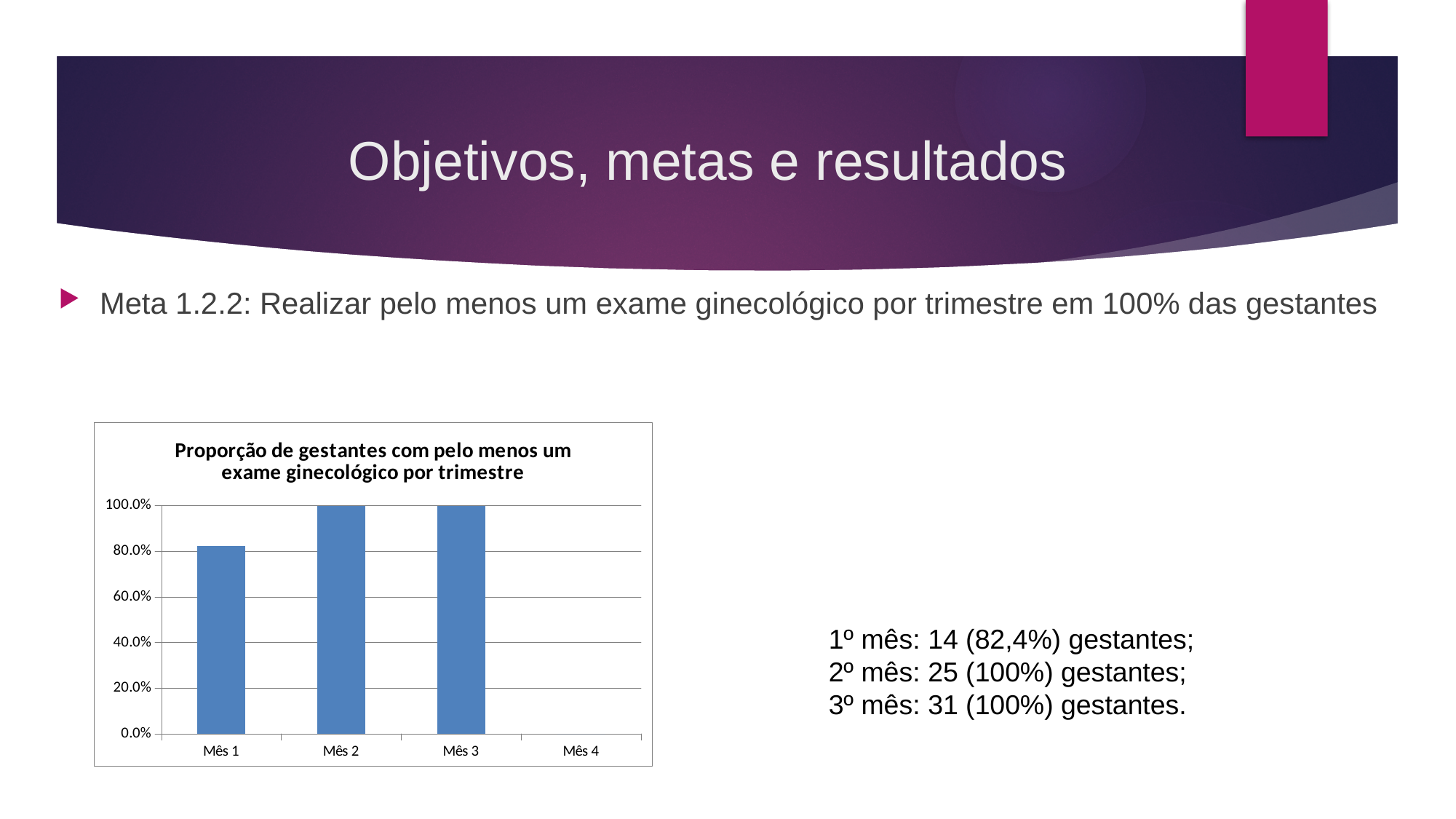
Is the value for Mês 1 greater or less than 100.0%? less How many bars are plotted in the chart? 3 Which is larger, the value for Mês 1 or the value for Mês 2? Mês 2 What is the title of the chart? Proporção de gestantes com pelo menos um exame ginecológico por trimestre Is the value for Mês 1 greater or less than 60.0%? greater Do the values rise or fall from Mês 1 to Mês 2? rise How many categories are labelled on the x axis of the chart? 4 What is the value for Mês 2 in the chart? 100.0% According to the slide, what proportion of gestantes had the exam in the 1º mês? 82,4% What is the value for Mês 3 in the chart? 100.0% What kind of chart is shown on the slide? bar chart